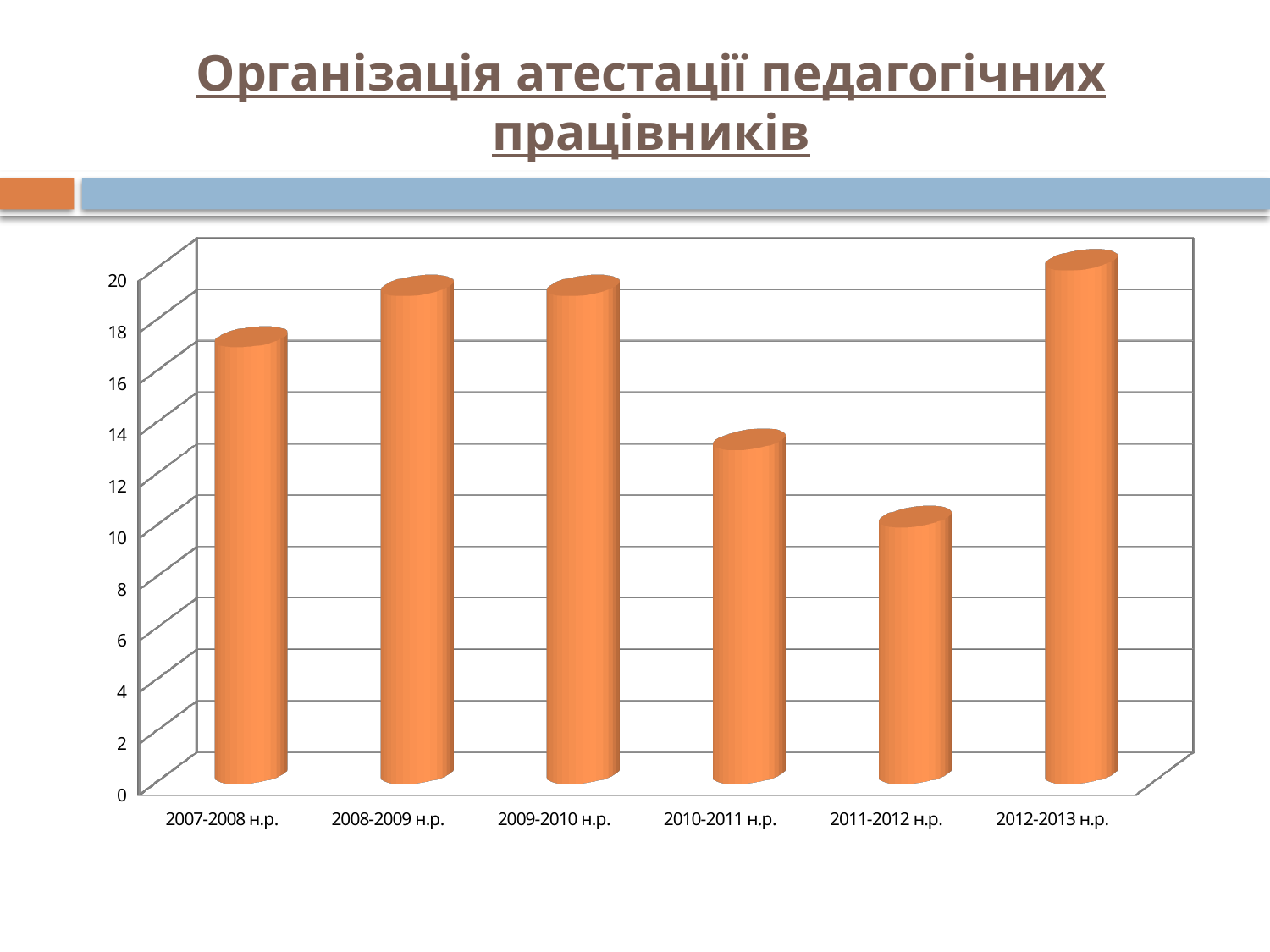
Is the value for 2011-2012 н.р. greater or less than 12? less Which is larger, the value for 2008-2009 н.р. or the value for 2010-2011 н.р.? 2008-2009 н.р. Which academic year has the lowest bar? 2011-2012 н.р. What kind of chart is shown on the slide? bar chart Which is larger, the value for 2011-2012 н.р. or the value for 2007-2008 н.р.? 2007-2008 н.р. How many academic years (categories) are shown on the x axis? 6 What colour are the bars in the chart? orange Which academic year has the highest bar? 2012-2013 н.р. Is the value for 2010-2011 н.р. greater or less than 16? less Is the value for 2012-2013 н.р. greater or less than 18? greater Do the values rise or fall from 2009-2010 н.р. to 2011-2012 н.р.? fall